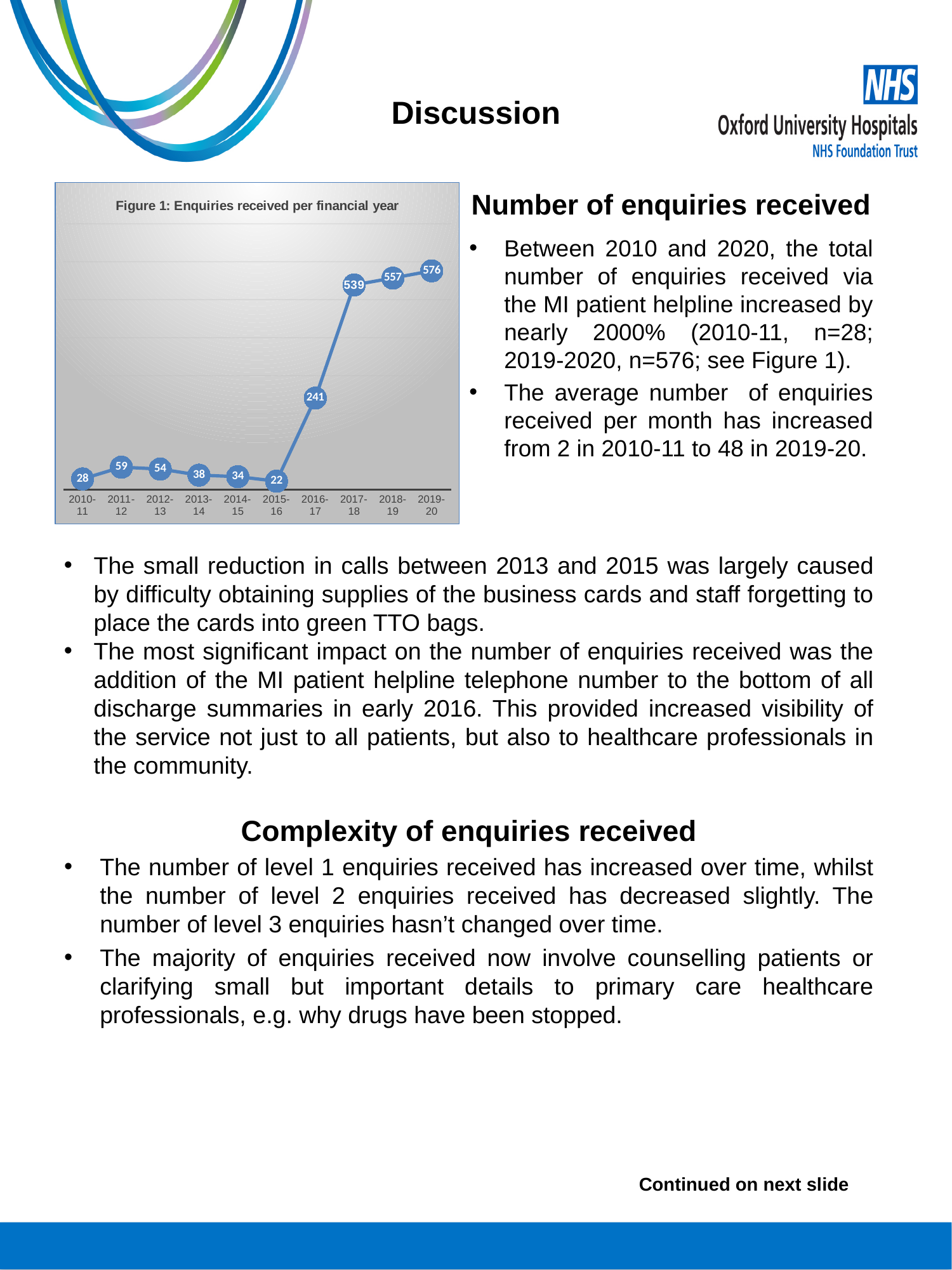
What is the value for 2018-19 in Figure 1? 557 What is the difference between the values for 2019-20 and 2010-11 in Figure 1? 548 What is the value for 2016-17 in Figure 1? 241 Which financial year has the lowest number of enquiries in Figure 1? 2015-16 What is the value for 2010-11 in Figure 1? 28 What is the title of the chart on the slide? Figure 1: Enquiries received per financial year What is the difference between the values for 2017-18 and 2016-17 in Figure 1? 298 Which financial year has the highest number of enquiries in Figure 1? 2019-20 How many financial years are plotted in Figure 1? 10 Do the values in Figure 1 rise or fall from 2015-16 to 2019-20? rise What kind of chart is Figure 1? line chart Which is larger in Figure 1, the value for 2011-12 or the value for 2012-13? 2011-12